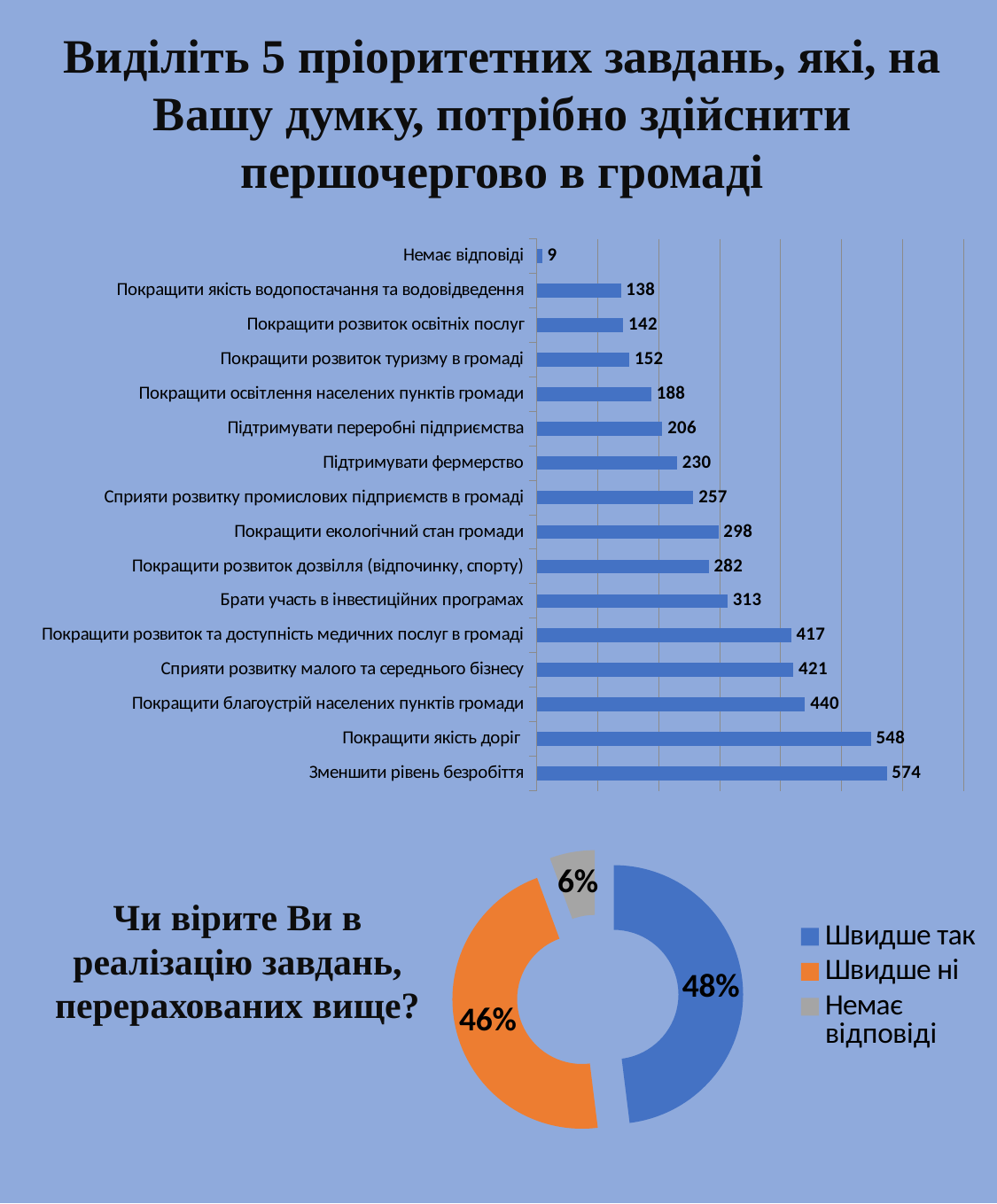
What kind of chart is the top chart on the slide? Bar chart In the top bar chart, what is the value for "Зменшити рівень безробіття"? 574 How many entries does the legend of the bottom doughnut chart list? 3 In the bottom doughnut chart, which slice is the smallest? Немає відповіді In the top bar chart, which category has the lowest value? Немає відповіді In the top bar chart, what is the value for "Підтримувати фермерство"? 230 In the bottom doughnut chart, what share is "Швидше ні"? 46% In the top bar chart, which category has the highest value? Зменшити рівень безробіття In the top bar chart, which is larger: "Покращити екологічний стан громади" or "Покращити розвиток дозвілля (відпочинку, спорту)"? Покращити екологічний стан громади How many categories are shown in the top bar chart? 16 In the top bar chart, what is the value for "Покращити якість доріг"? 548 In the top bar chart, what is the difference between "Покращити благоустрій населених пунктів громади" and "Сприяти розвитку малого та середнього бізнесу"? 19